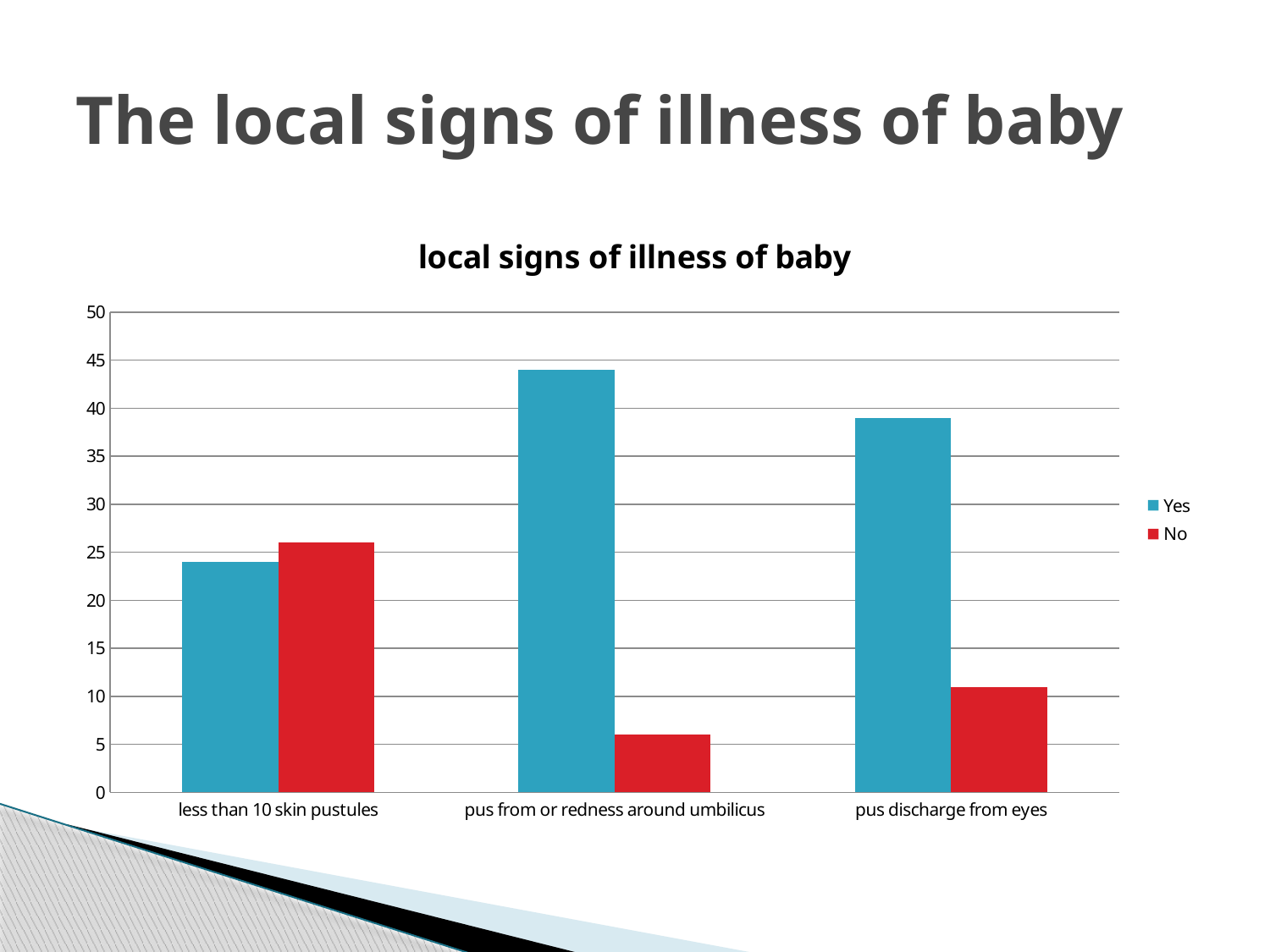
Is the No value for pus discharge from eyes greater or less than 15? less Which category has the highest Yes value? pus from or redness around umbilicus Which colour represents the No series in the chart? red How many series does the legend list? 2 Which category has the highest No value? less than 10 skin pustules Which category has the lowest No value? pus from or redness around umbilicus What kind of chart is shown on the slide? bar chart Is the Yes value for pus from or redness around umbilicus greater or less than 40? greater For pus discharge from eyes, which is larger, the Yes value or the No value? Yes What is the title of the chart? local signs of illness of baby Is the Yes value for less than 10 skin pustules greater or less than 20? greater How many categories are shown on the x axis? 3